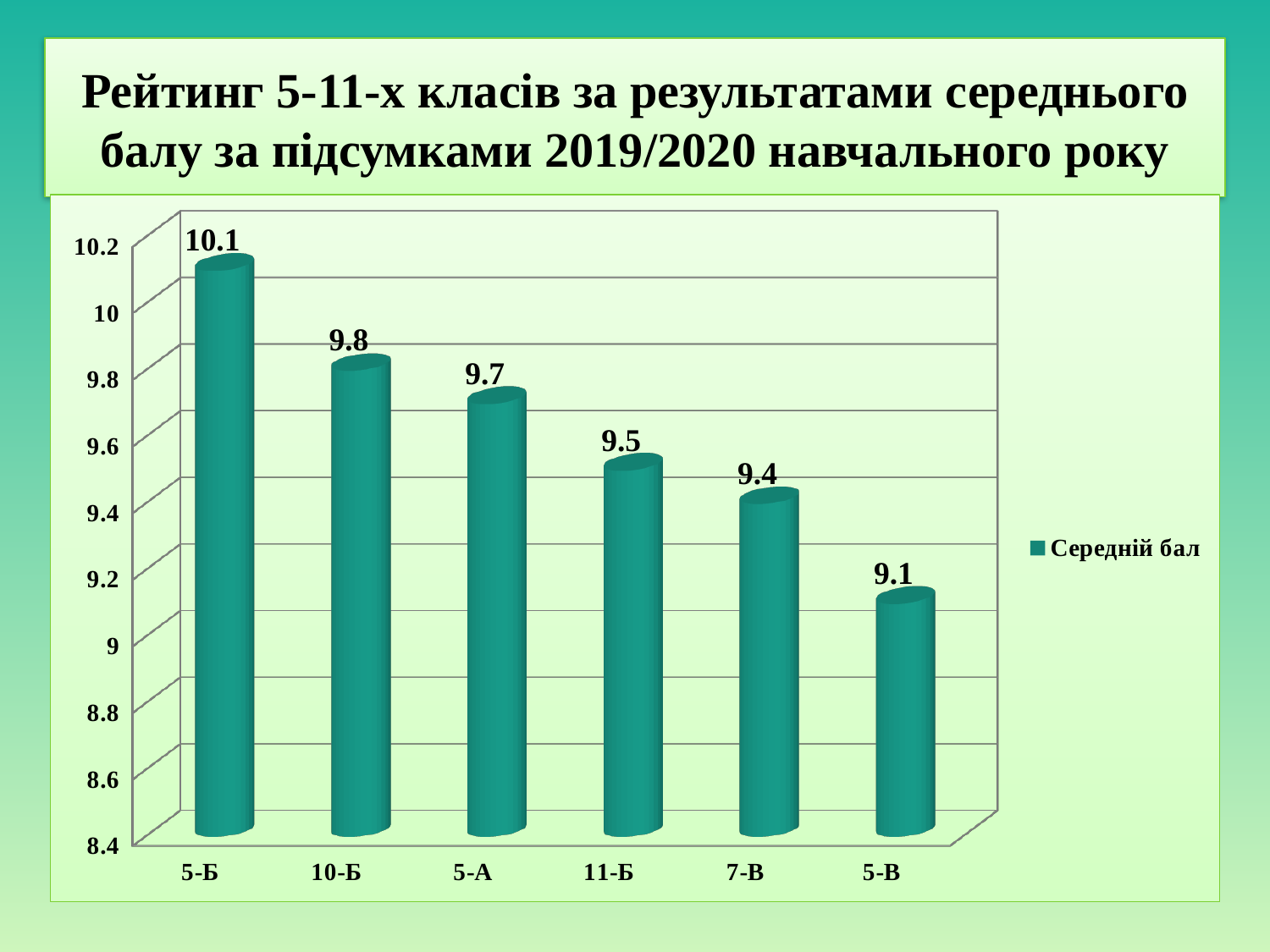
What is the difference between the average scores of 5-Б and 5-В? 1 How many classes are shown on the chart? 6 What is the average score for class 11-Б? 9.5 Do the values rise or fall from left to right along the x axis? fall What kind of chart is shown on the slide? bar chart What is the average score for class 7-В? 9.4 Is the value for 5-В greater or less than 9.2? less Which class has a higher average score, 10-Б or 7-В? 10-Б What is the difference between the average scores of 10-Б and 5-А? 0.1 Which class has the lowest average score? 5-В Which class has the highest average score? 5-Б What is the average score (Середній бал) for class 5-Б? 10.1